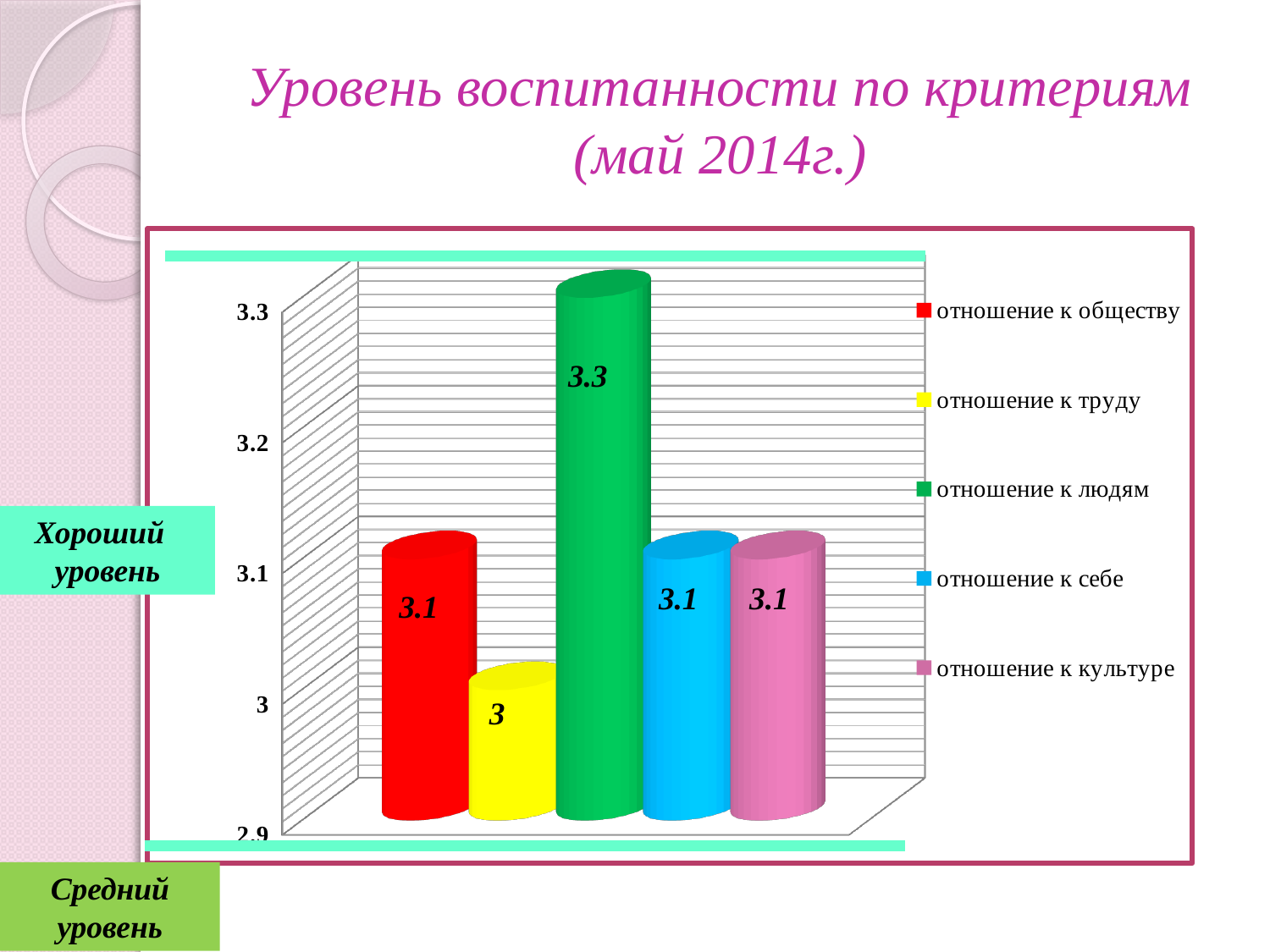
What is the value for отношение к людям? 3.3 What is the value for отношение к труду? 3 What is the value for отношение к культуре? 3.1 Which criterion has the lowest value? отношение к труду What colour is the bar for отношение к людям? green What is the difference between the values for отношение к людям and отношение к труду? 0.3 Which is larger, the value for отношение к людям or the value for отношение к себе? отношение к людям Which criterion has the highest value? отношение к людям Is the value for отношение к людям greater or less than 3.2? greater What kind of chart is shown on the slide? bar chart What is the value for отношение к обществу? 3.1 How many series does the legend list? 5